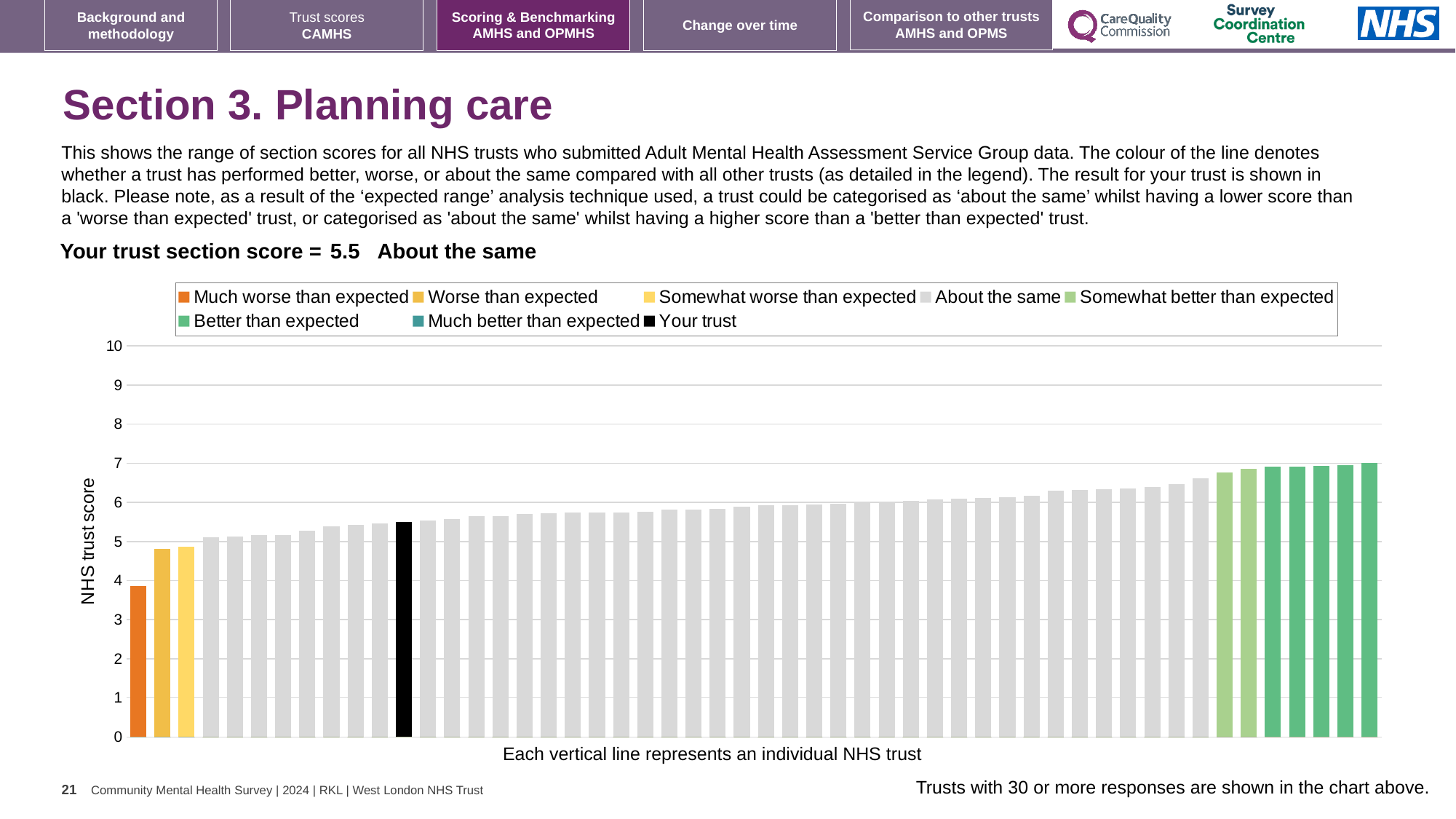
Which legend category does the lowest bar belong to? Much worse than expected What is the section score for your trust? 5.5 Is the value of the highest bar greater or less than 6? greater Is the value of the lowest bar (the orange bar) greater or less than 5? less Which benchmarking category is your trust placed in for this section? About the same What is the label on the y axis of the chart? NHS trust score What kind of chart is shown on the slide? bar chart How many entries does the chart legend list? 8 Is the value of the highest bar greater or less than 8? less Do the bar values rise or fall from left to right along the x axis? rise How many bars are coloured as 'Worse than expected' (yellow)? 1